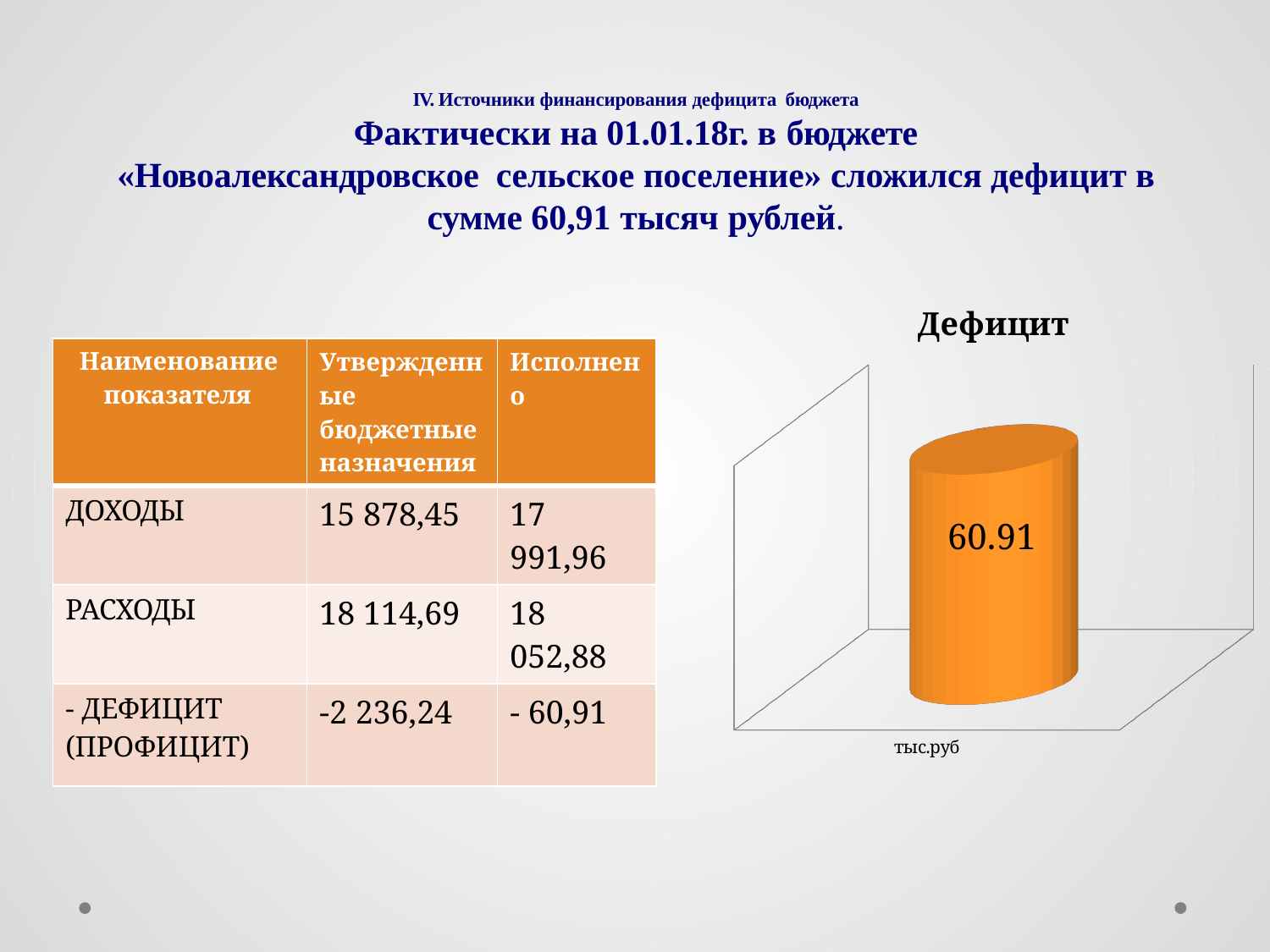
What kind of chart is the "Дефицит" chart? bar chart What is the title of the chart on the right side of the slide? Дефицит What value is shown on the bar in the chart titled "Дефицит"? 60.91 What unit label is printed below the "Дефицит" chart? тыс.руб How many bars are plotted in the "Дефицит" chart? 1